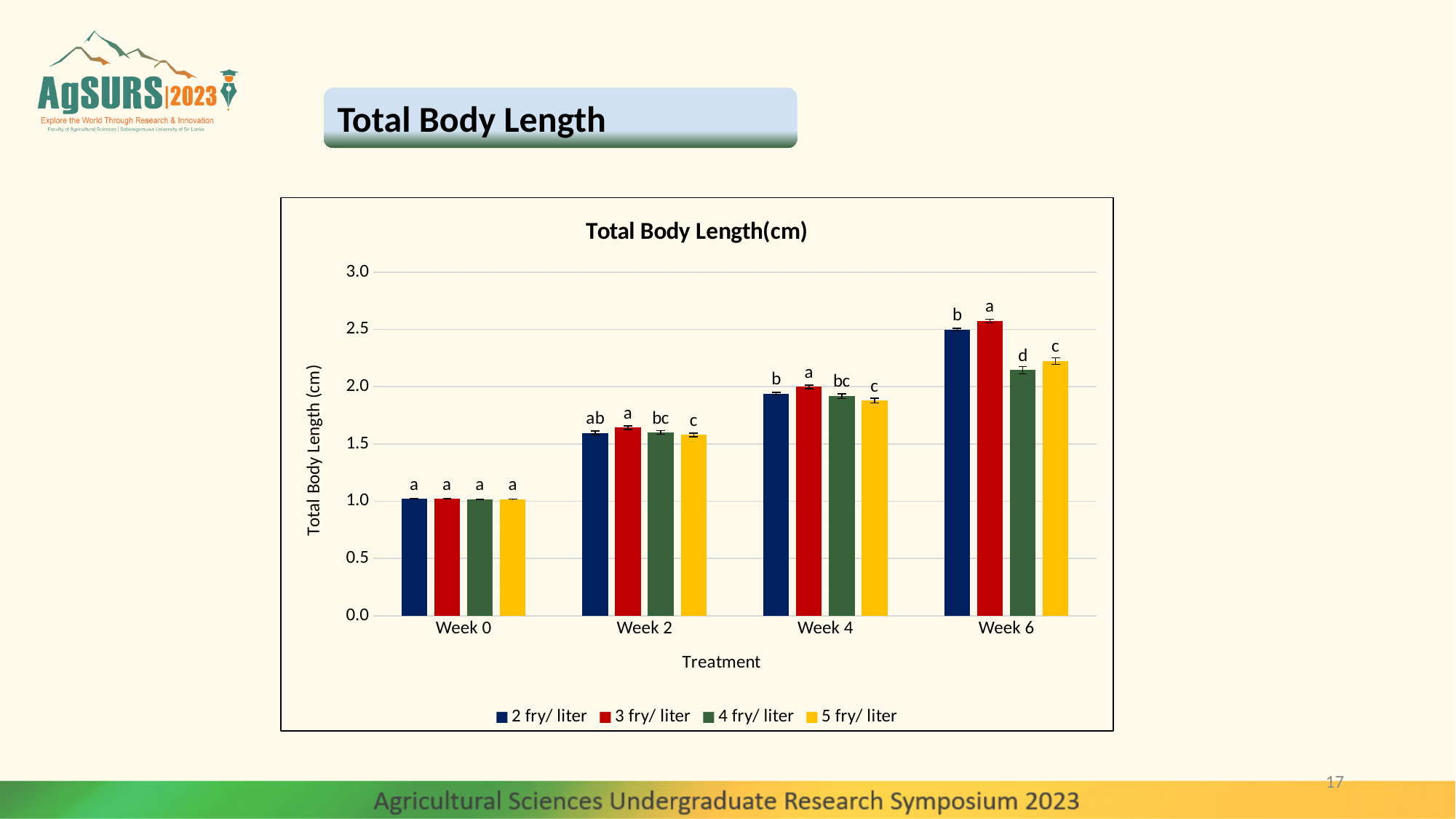
How many series does the legend list? 4 Is the value for 2 fry/ liter at Week 2 greater or less than 1.5? greater Is the value for 4 fry/ liter at Week 6 greater or less than 2.5? less At Week 6, which is larger: the value for 2 fry/ liter or the value for 4 fry/ liter? 2 fry/ liter What is the label on the x axis of the chart? Treatment At Week 6, which stocking density has the highest total body length? 3 fry/ liter How many week categories are shown on the x axis? 4 What is the title of the chart? Total Body Length(cm) Is the value for 5 fry/ liter at Week 4 greater or less than 2.0? less At Week 6, which stocking density has the lowest total body length? 4 fry/ liter What kind of chart is shown on the slide? bar chart Do the total body length values rise or fall from Week 0 to Week 6? rise